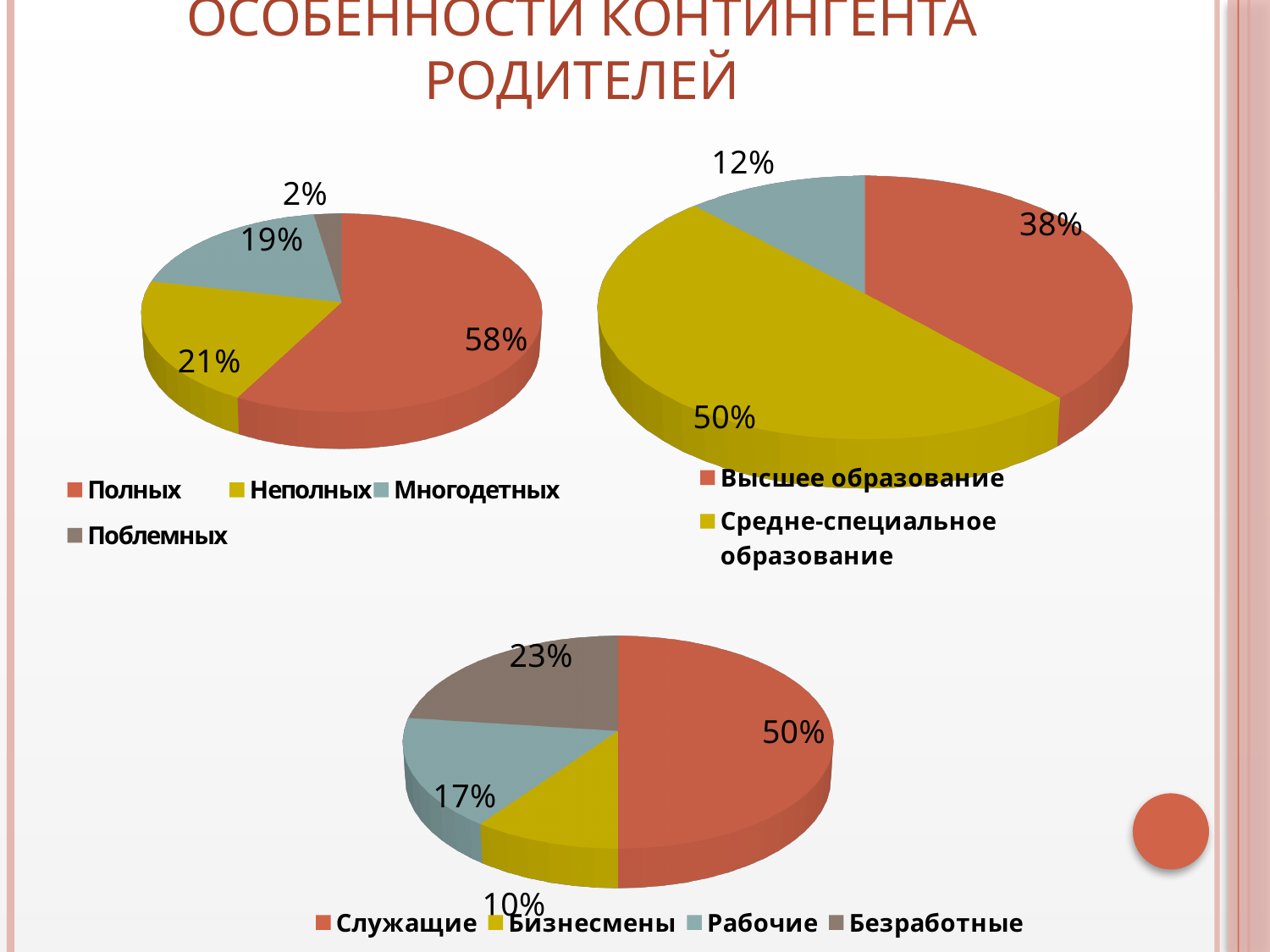
On the top-right pie chart, what percentage is shown for Средне-специальное образование? 50% On the top-right pie chart, what percentage is shown for Высшее образование? 38% On the top-left pie chart, what percentage is shown for Полных? 58% What type of chart is the bottom chart on the slide? Pie chart On the top-right pie chart, which is larger: Высшее образование or Средне-специальное образование? Средне-специальное образование On the top-left pie chart, what is the difference between the shares of Неполных and Многодетных? 2% How many pie charts are shown on the slide? 3 On the top-left pie chart, how many categories does the legend list? 4 On the top-left pie chart, which category has the smallest share? Поблемных On the bottom pie chart, which category has the largest share? Служащие On the bottom pie chart, what percentage is shown for Безработные? 23% On the bottom pie chart, what is the difference between the shares of Рабочие and Бизнесмены? 7%